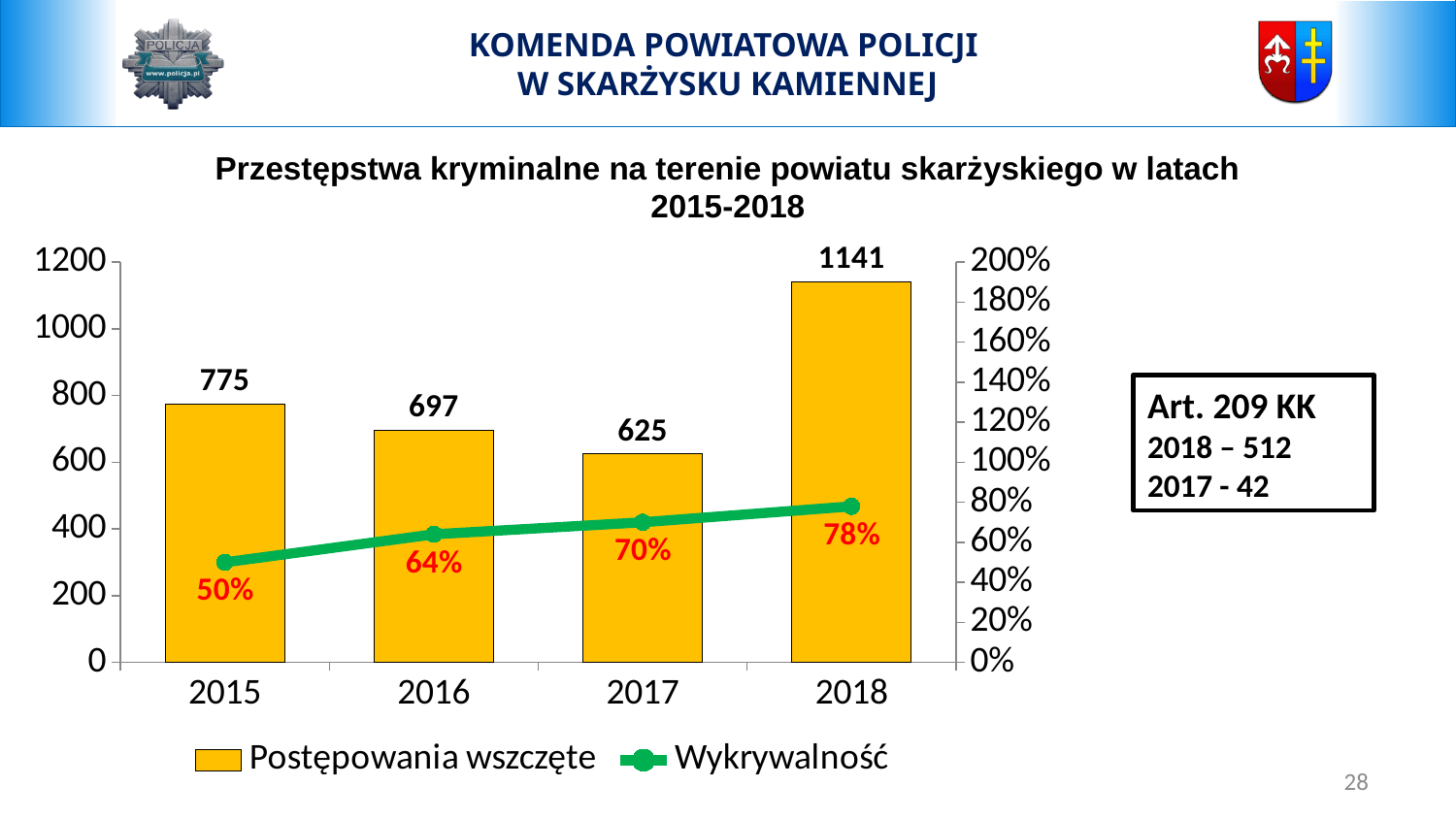
What colour are the bars for Postępowania wszczęte? yellow Which year has the highest value of Postępowania wszczęte? 2018 What is the title of the chart? Przestępstwa kryminalne na terenie powiatu skarżyskiego w latach 2015-2018 What is the Wykrywalność value for 2016? 64% What is the difference between Postępowania wszczęte in 2018 and 2017? 516 How many years are shown on the x axis? 4 Which year has the lowest Wykrywalność? 2015 How many series does the legend list? 2 What is the value of Postępowania wszczęte for 2017? 625 What is the value of Postępowania wszczęte for 2018? 1141 Which is larger, Postępowania wszczęte in 2015 or in 2016? 2015 Does Wykrywalność rise or fall from 2015 to 2018? rise